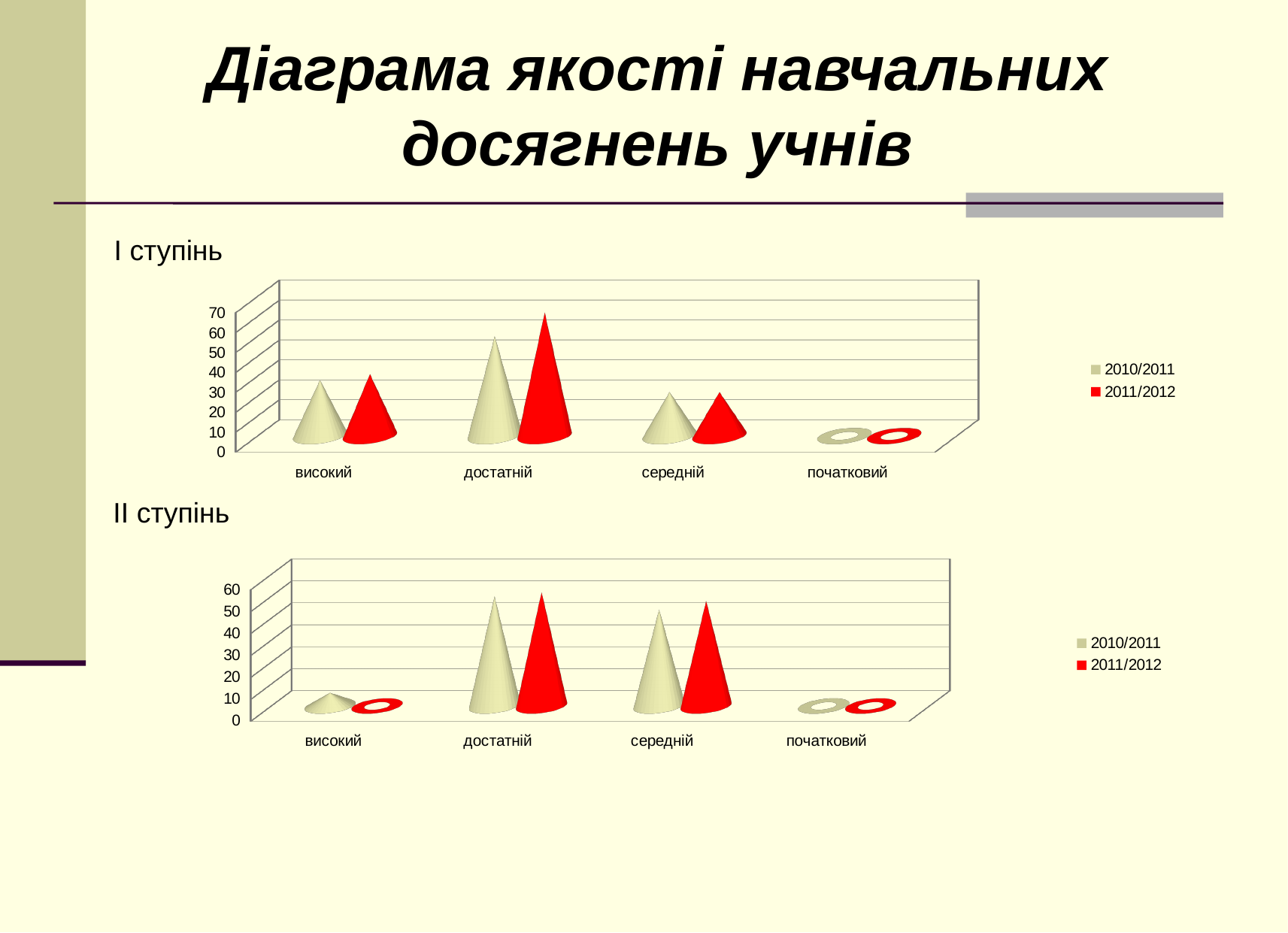
Which series is shown in red in the legend of the 'I ступінь' chart? 2011/2012 In the 'II ступінь' chart, for 2010/2011, which is larger: високий or достатній? достатній What kind of chart is the 'I ступінь' chart? bar chart In the 'I ступінь' chart, which category has the lowest value for 2010/2011? початковий How many series does the legend of the 'II ступінь' chart list? 2 In the 'II ступінь' chart, is the value for середній in 2011/2012 greater or less than 40? greater In the 'I ступінь' chart, is the value for достатній in 2011/2012 greater or less than 50? greater How many categories are shown on the x axis of the 'I ступінь' chart? 4 In the 'II ступінь' chart, which category has the highest value for 2010/2011? достатній In the 'I ступінь' chart, for достатній, which series is larger: 2010/2011 or 2011/2012? 2011/2012 In the 'I ступінь' chart, is the value for високий in 2010/2011 greater or less than 40? less In the 'I ступінь' chart, which category has the highest value for 2011/2012? достатній